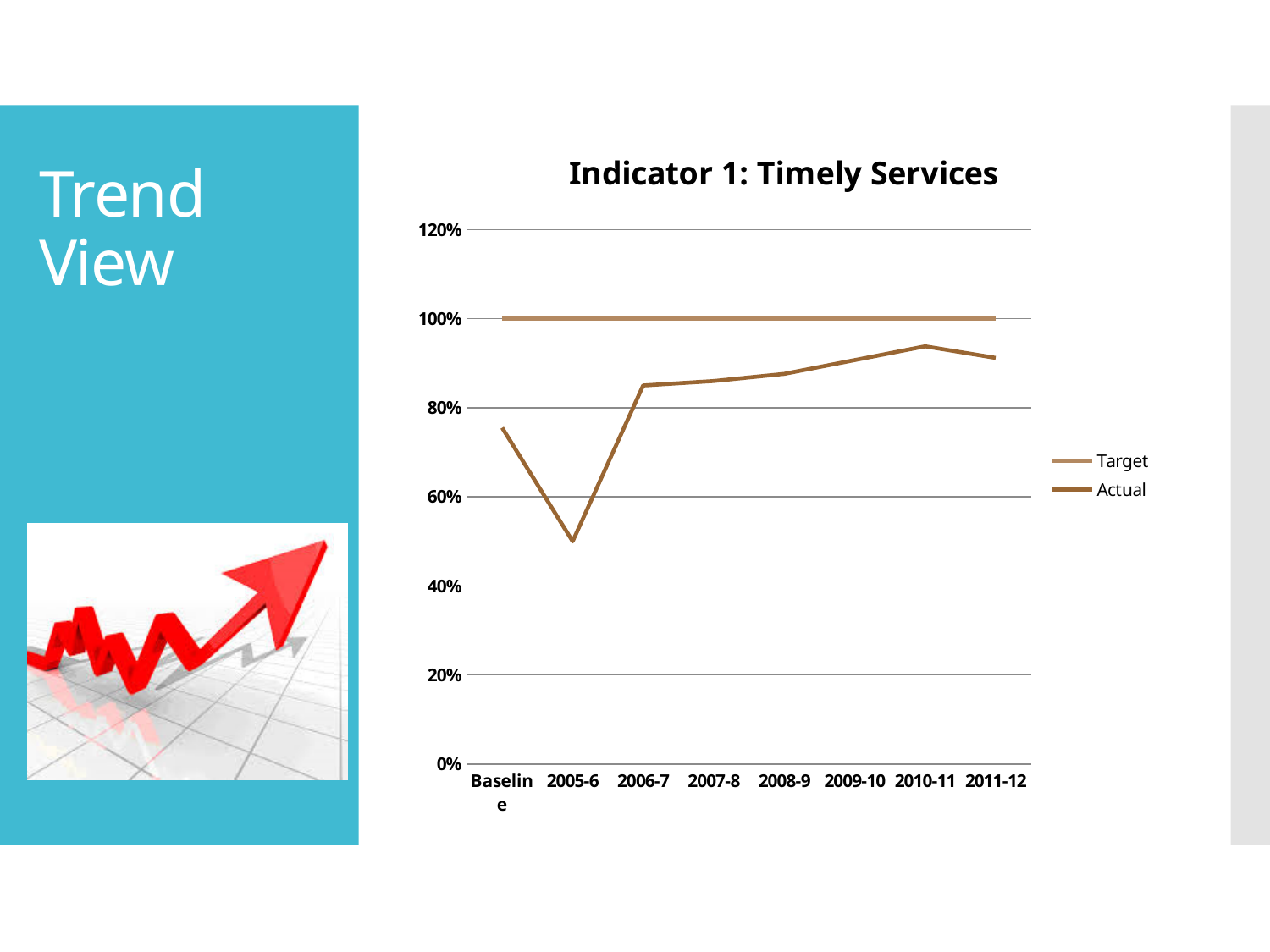
Which is larger, the Actual value for Baseline or for 2005-6? Baseline What is the Target value across all periods? 100% Is the Actual value for Baseline greater or less than 60%? greater How many categories are shown on the x axis? 8 How many series does the legend list? 2 What kind of chart is shown on the slide? line chart Is the Actual value for 2005-6 greater or less than 60%? less Is the Actual value for 2006-7 greater or less than 80%? greater In which period is the Actual value highest? 2010-11 In which period is the Actual value lowest? 2005-6 Does the Actual line rise or fall from 2005-6 to 2010-11? rise What is the title of the chart? Indicator 1: Timely Services